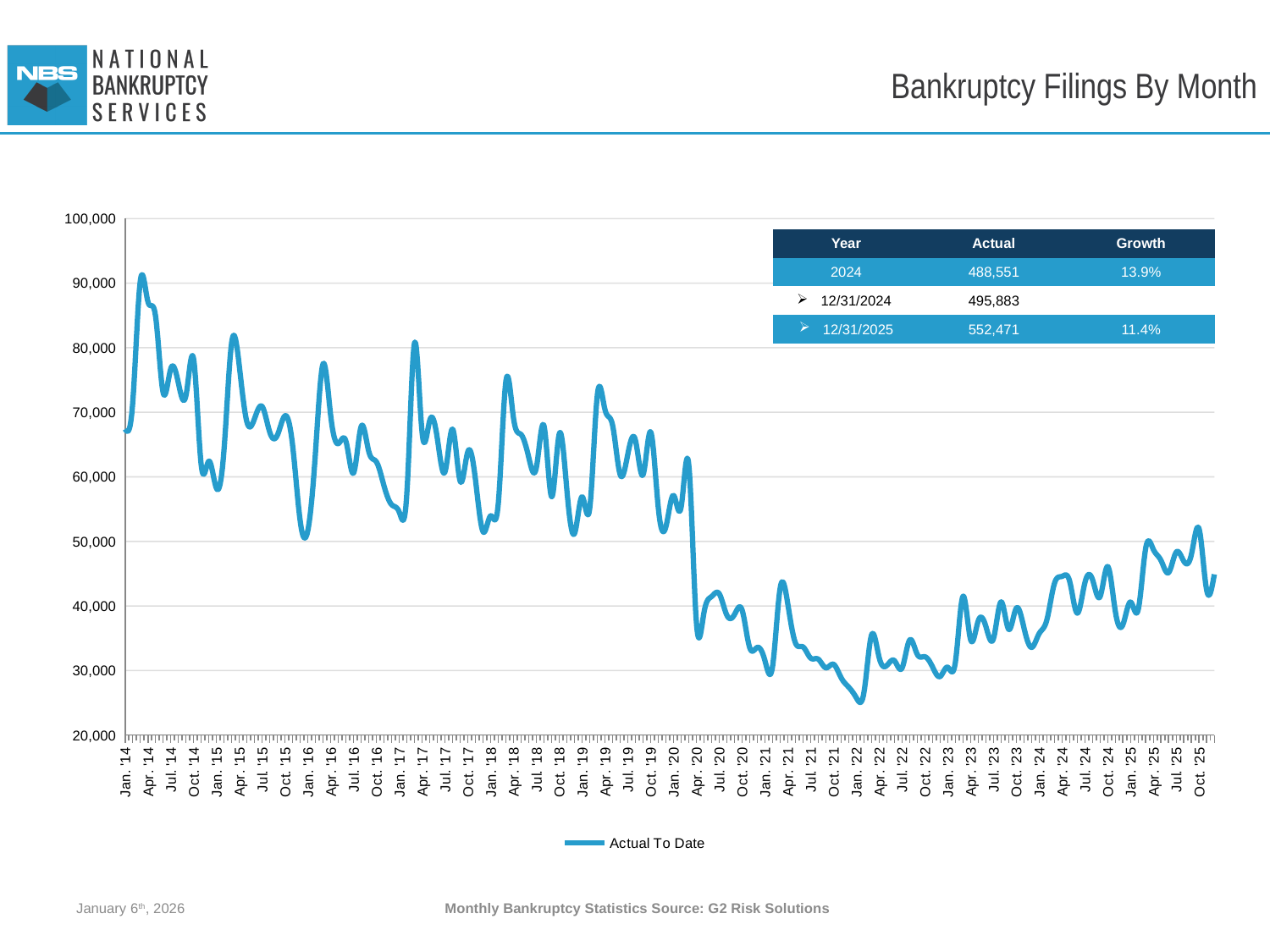
Is the value for Jan. '22 greater or less than 30,000? less What kind of chart is shown on the slide? line chart In the table on the chart, what is the Actual value for 12/31/2025? 552,471 Is the value for Jan. '14 greater or less than 60,000? greater How many series does the legend list? 1 What is the title of the chart? Bankruptcy Filings By Month Around which month does the line reach its lowest point? Jan. '22 Is the value for Apr. '20 greater or less than 40,000? less Do the values generally rise or fall from Jan. '22 to Oct. '25? rise Around which month does the line reach its highest point? Mar. '14 What is the name of the series shown in the legend? Actual To Date